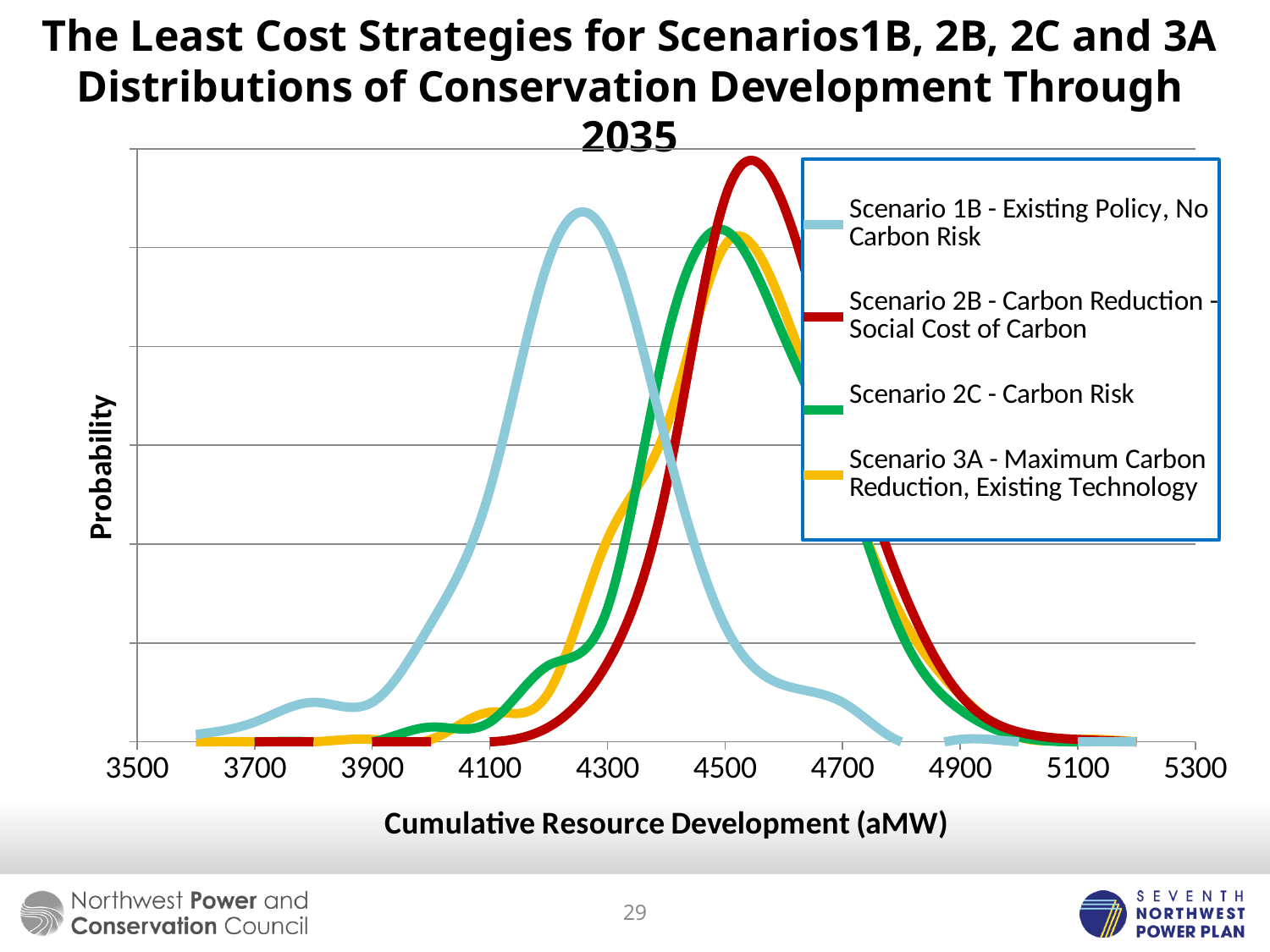
What is the lowest value labelled on the x axis? 3500 At 4300 aMW, which curve has the higher probability, Scenario 1B or Scenario 2B? Scenario 1B How many tick labels are shown on the x axis? 10 What kind of chart is shown on the slide? Line chart What is the title of the y axis? Probability Which scenario's curve peaks at the lowest cumulative resource development? Scenario 1B - Existing Policy, No Carbon Risk What is the title of the x axis? Cumulative Resource Development (aMW) At 4700 aMW, which curve has the higher probability, Scenario 2B or Scenario 1B? Scenario 2B How many series does the legend list? 4 Which scenario's curve reaches the highest peak probability? Scenario 2B - Carbon Reduction - Social Cost of Carbon